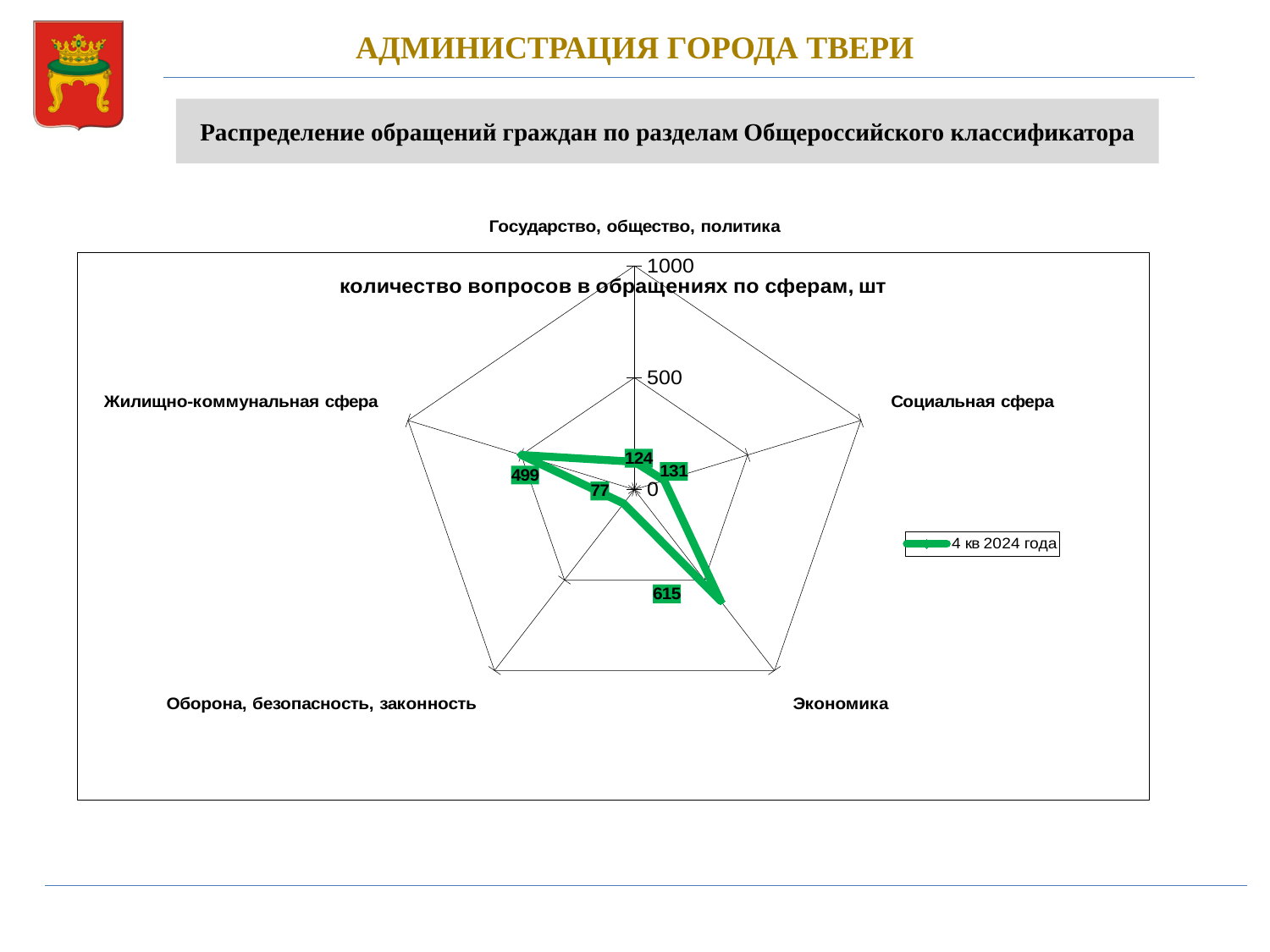
What is the value for Социальная сфера? 131 What type of chart is shown on the slide? radar chart How many categories are plotted on the chart? 5 What is the value for Экономика? 615 Which category has the highest value? Экономика What is the value for Жилищно-коммунальная сфера? 499 What is the value for Государство, общество, политика? 124 What series does the legend list? 4 кв 2024 года What is the difference between the values for Экономика and Жилищно-коммунальная сфера? 116 Which category has the lowest value? Оборона, безопасность, законность What is the value for Оборона, безопасность, законность? 77 Which is larger, the value for Социальная сфера or the value for Государство, общество, политика? Социальная сфера